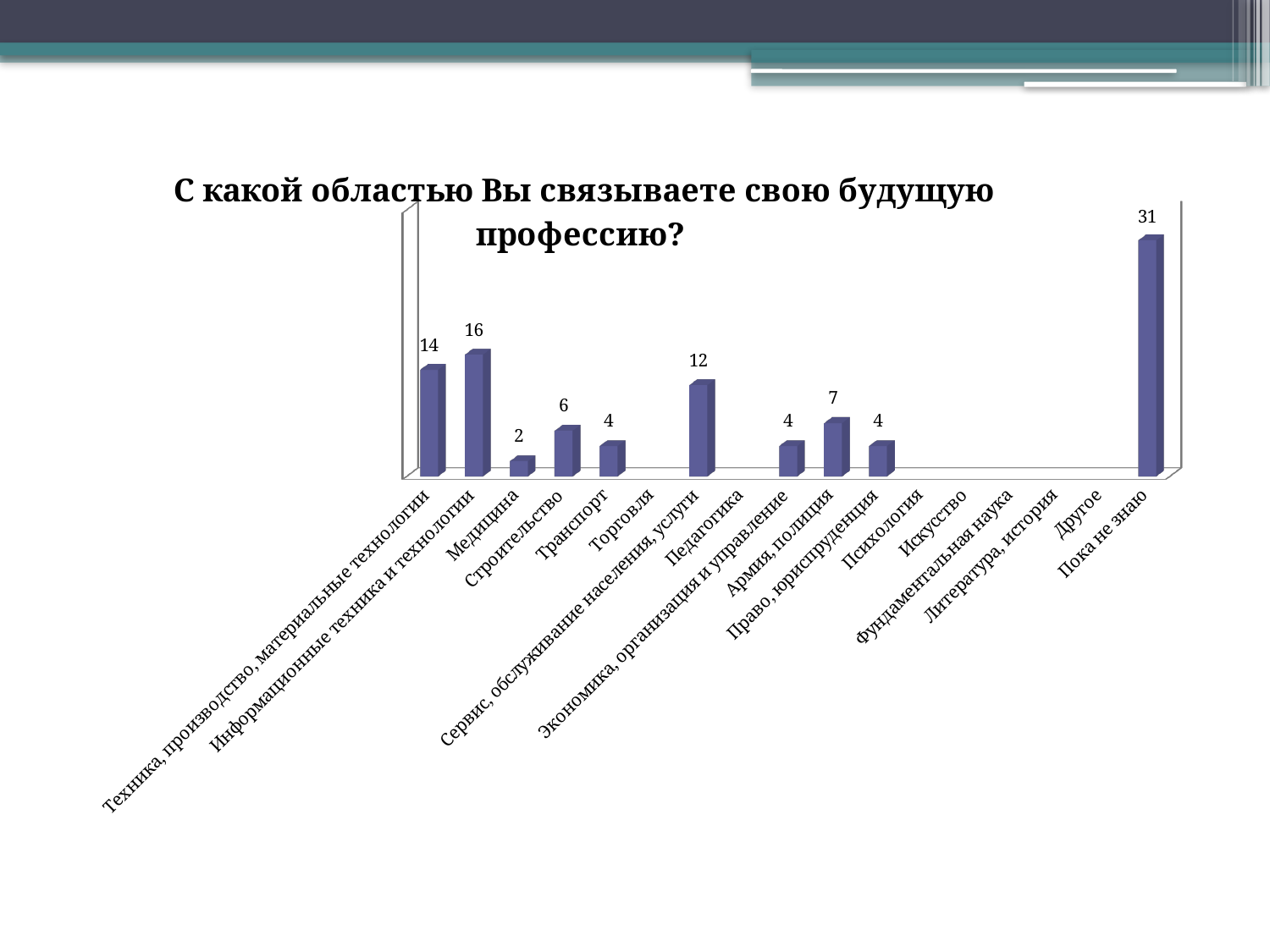
How many categories are shown on the x axis? 17 What is the title of the chart? С какой областью Вы связываете свою будущую профессию? What is the value for Пока не знаю? 31 What is the value for Армия, полиция? 7 What is the value for Медицина? 2 What is the value for Сервис, обслуживание населения, услуги? 12 Which category has the highest value? Пока не знаю What is the difference between the values for Пока не знаю and Информационные техника и технологии? 15 What is the value for Информационные техника и технологии? 16 Which is larger, the value for Строительство or the value for Транспорт? Строительство Which category with a labelled bar has the lowest value? Медицина What kind of chart is shown on the slide? Bar chart